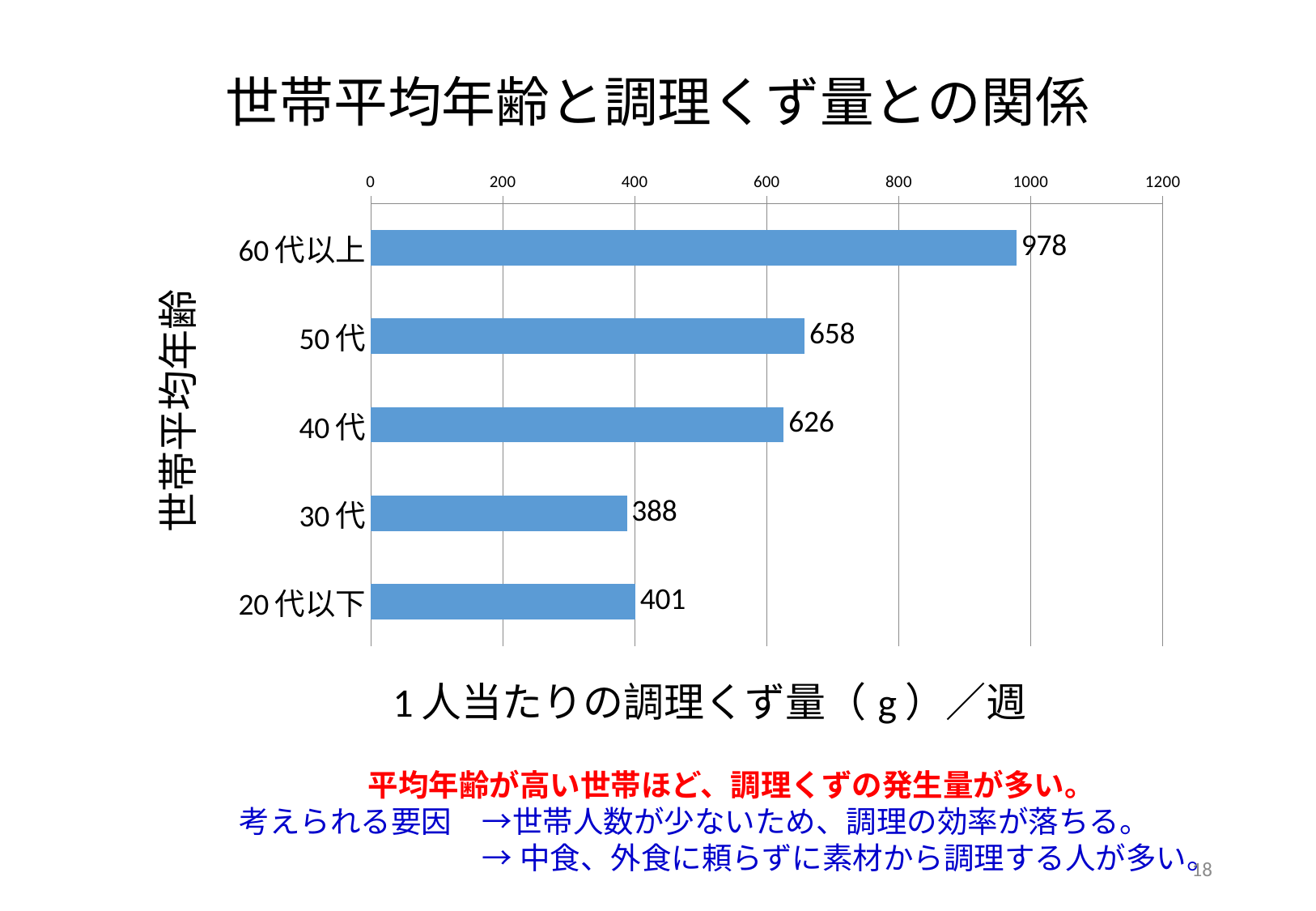
What is the value for 20代以下? 401 What kind of chart is shown on the slide? bar chart Which age group has the lowest value? 30代 How many age groups are shown in the chart? 5 What is the value for 30代? 388 What is the difference between the values for 60代以上 and 50代? 320 Which age group has the highest value? 60代以上 What is the value for 50代? 658 What is the title of the chart? 世帯平均年齢と調理くず量との関係 Is the value for 40代 greater or less than 600? greater What is the value for 60代以上? 978 Which is larger, the value for 40代 or the value for 30代? 40代